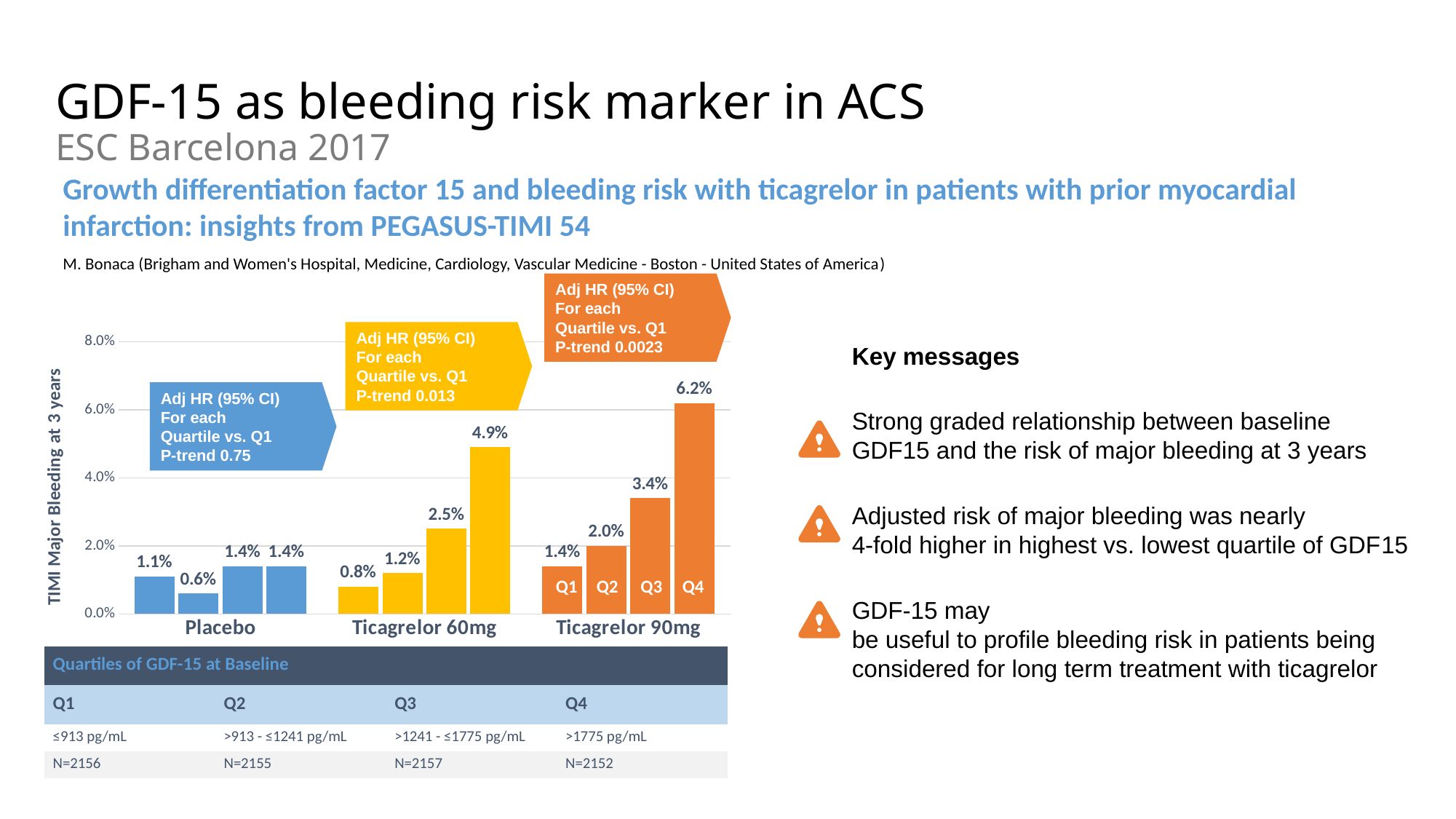
What is the TIMI major bleeding rate at 3 years for Q4 in the Ticagrelor 90mg group? 6.2% Which treatment group and quartile has the highest TIMI major bleeding rate on the chart? Ticagrelor 90mg, Q4 What is the TIMI major bleeding rate at 3 years for Q3 in the Ticagrelor 60mg group? 2.5% Which treatment group and quartile has the lowest TIMI major bleeding rate on the chart? Placebo, Q2 What is the TIMI major bleeding rate at 3 years for Q2 in the Placebo group? 0.6% What is the P-trend shown for the Placebo group? 0.75 What is the difference in TIMI major bleeding rate between Q4 and Q1 in the Ticagrelor 60mg group? 4.1% Is the Q4 bleeding rate for Ticagrelor 60mg greater or less than 4.0%? greater Which is larger: the Q3 bleeding rate for Ticagrelor 90mg or the Q3 bleeding rate for Ticagrelor 60mg? Ticagrelor 90mg How many bars are plotted in total across the three treatment groups? 12 What type of chart is used to show TIMI major bleeding at 3 years? Bar chart What is the difference in TIMI major bleeding rate between Q4 in the Ticagrelor 90mg group and Q4 in the Ticagrelor 60mg group? 1.3%